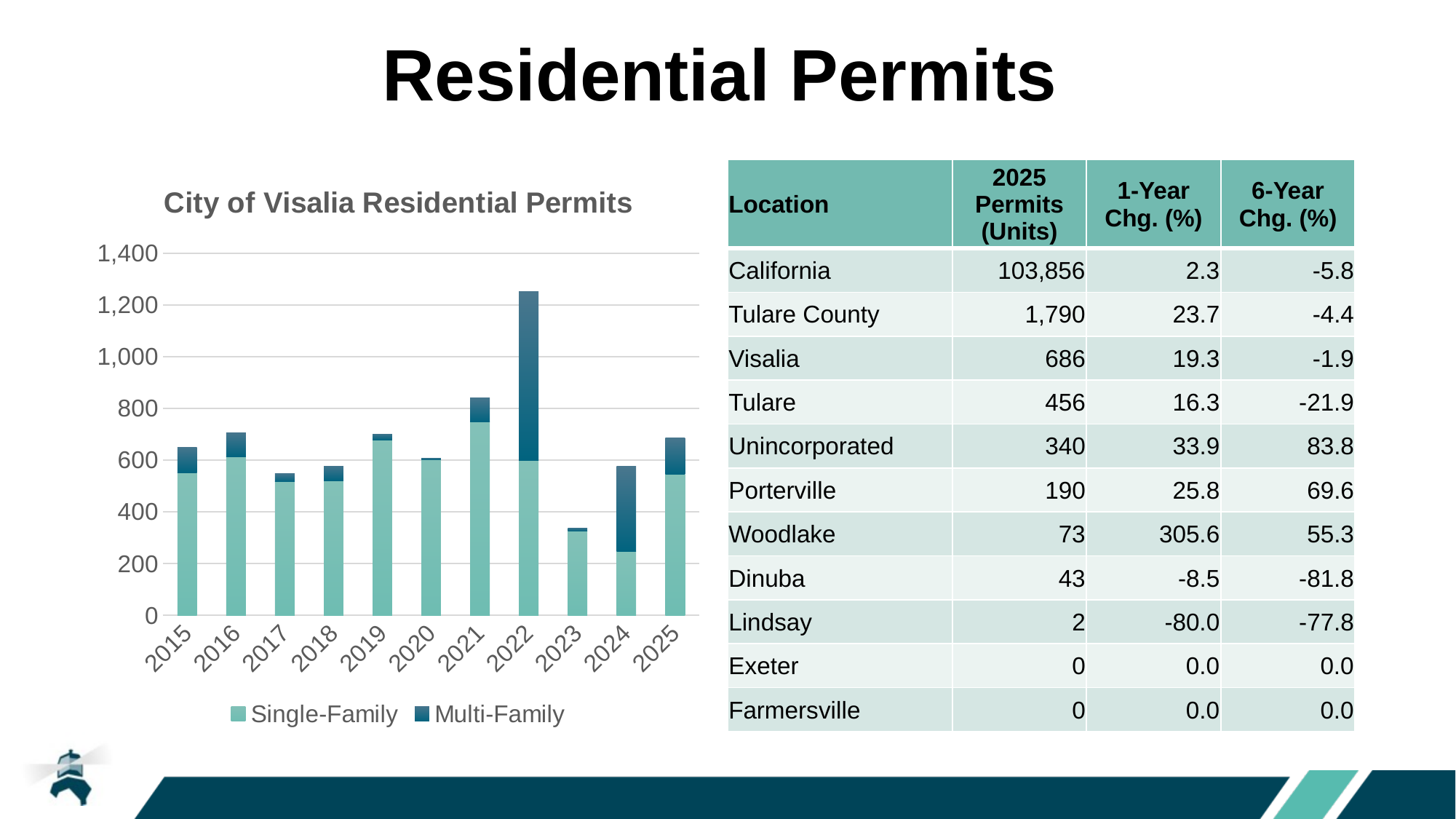
How many years are shown on the x axis of the City of Visalia Residential Permits chart? 11 Which year has the highest total residential permits in the City of Visalia Residential Permits chart? 2022 Is the total bar for 2022 in the City of Visalia Residential Permits chart greater or less than 1,200? greater Is the total bar for 2021 in the City of Visalia Residential Permits chart greater or less than 800? greater What type of chart is the City of Visalia Residential Permits chart? Stacked bar chart Which year has the larger total bar in the City of Visalia Residential Permits chart, 2023 or 2024? 2024 Which year has the lowest total residential permits in the City of Visalia Residential Permits chart? 2023 Which series is shown in the darker blue colour in the City of Visalia Residential Permits chart? Multi-Family Do total residential permits rise or fall from 2022 to 2023 in the City of Visalia Residential Permits chart? fall How many series does the legend of the City of Visalia Residential Permits chart list? 2 Is the Single-Family value for 2024 in the City of Visalia Residential Permits chart greater or less than 400? less